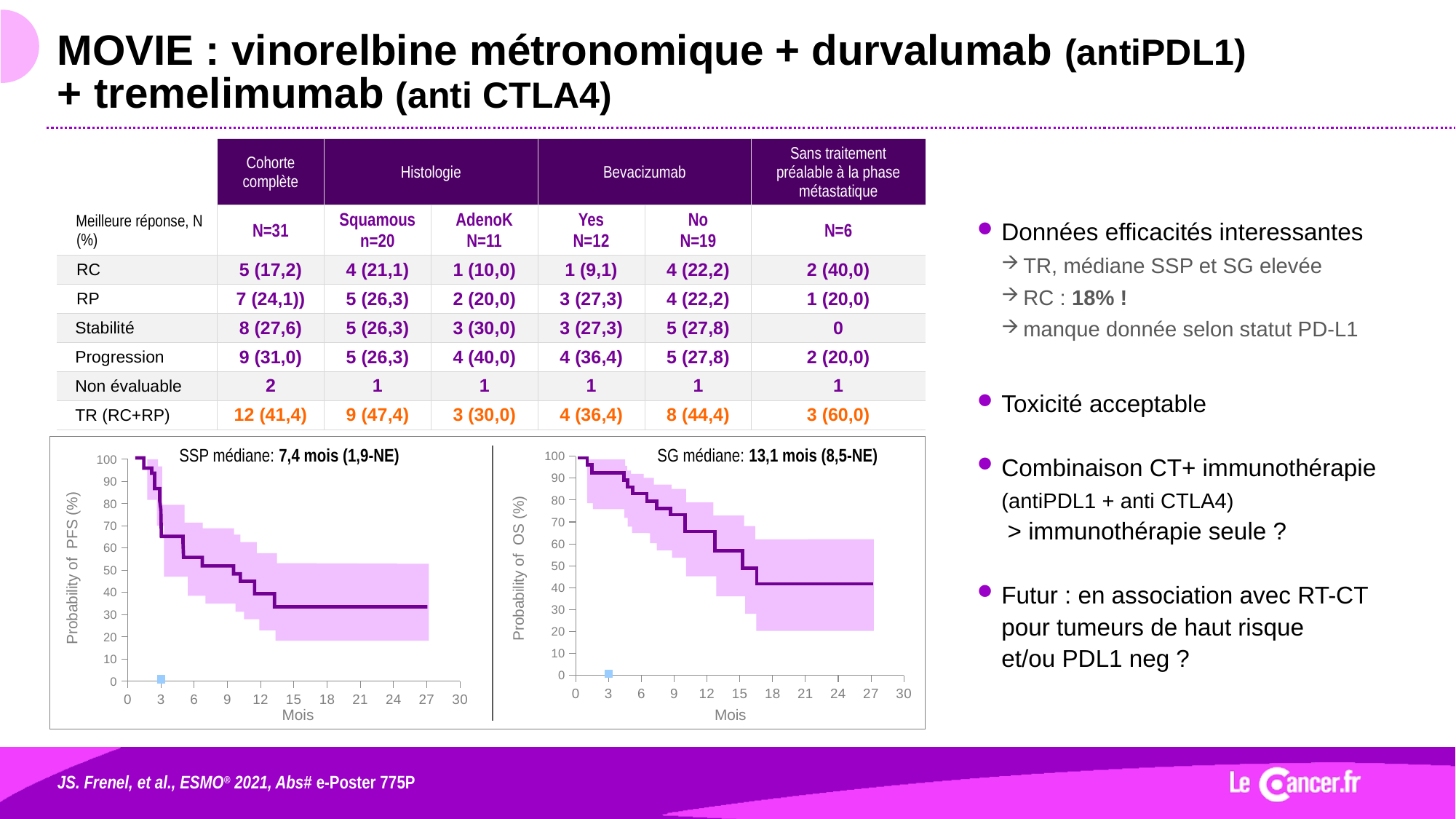
On the left chart, is the probability of PFS at 27 months greater or less than 40%? less What is the label of the x axis on both charts? Mois On the left chart, what is the median SSP (PFS) shown? 7,4 mois (1,9-NE) What is the maximum value shown on the x axis of the left chart? 30 On the left chart, does the probability of PFS rise or fall as months increase? Fall On the right chart, is the probability of OS at 3 months greater or less than 80%? greater On the right chart, does the probability of OS rise or fall along the x axis? Fall On the right chart, is the probability of OS at 27 months greater or less than 50%? less What kind of chart is the left chart (Probability of PFS)? Kaplan-Meier survival curve (step line chart) On the right chart, what is the median SG (OS) shown? 13,1 mois (8,5-NE) What is the difference between the median SG (right chart) and the median SSP (left chart)? 5,7 mois Which is larger, the median SG on the right chart or the median SSP on the left chart? Median SG (13,1 mois)